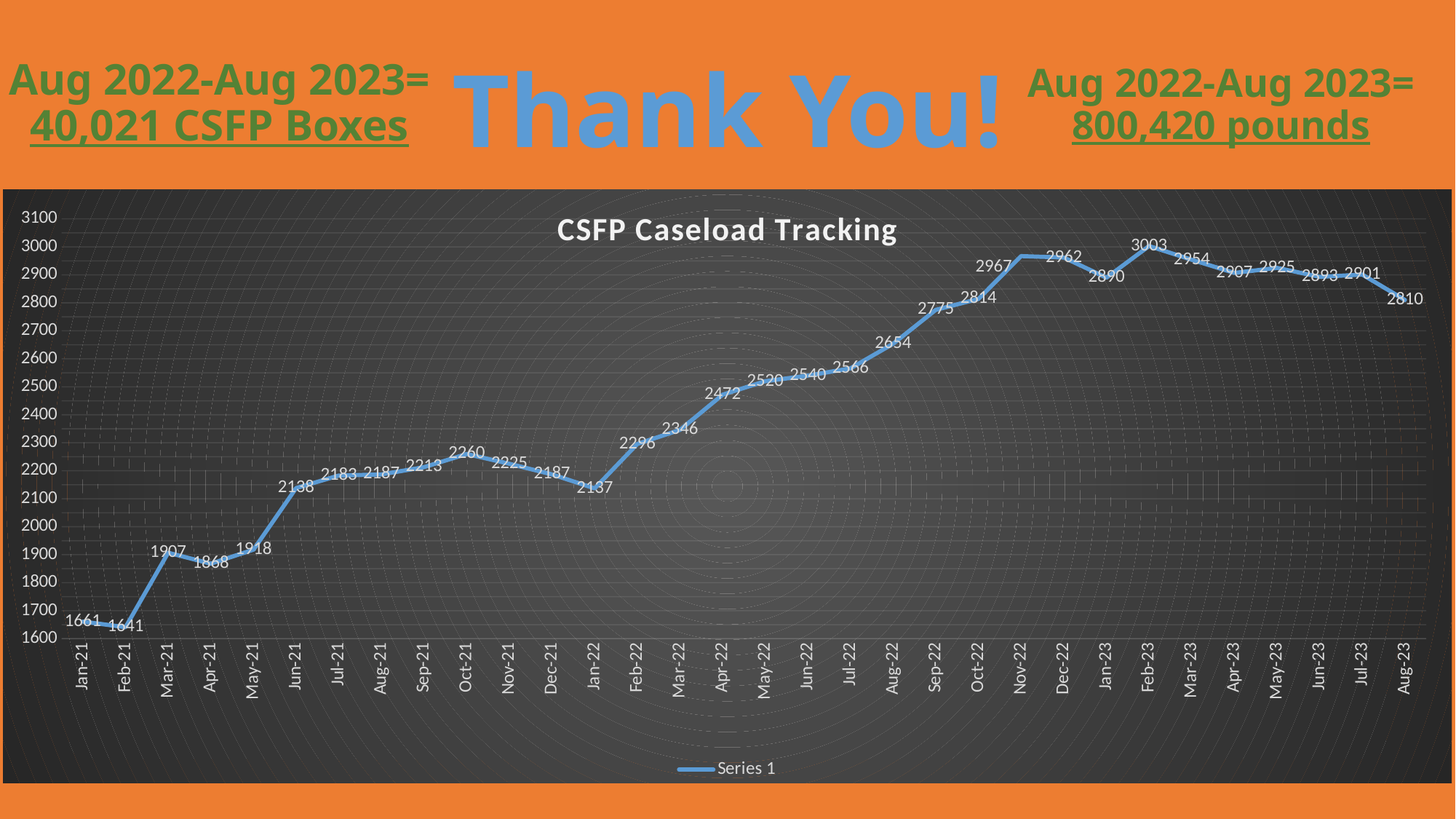
Which is larger, the value for Oct-21 or the value for Jan-22? Oct-21 What is the value for Nov-22? 2967 What type of chart is shown on the slide? Line chart Which month has the lowest value? Feb-21 How many series does the legend list? 1 What is the value for Aug-23? 2810 What is the title of the chart? CSFP Caseload Tracking What is the difference between the values for Feb-23 and Feb-21? 1362 How many data points are plotted on the chart? 32 What is the value for Jan-21? 1661 Overall, do the values rise or fall from Jan-21 to Aug-23? Rise Which month has the highest value? Feb-23